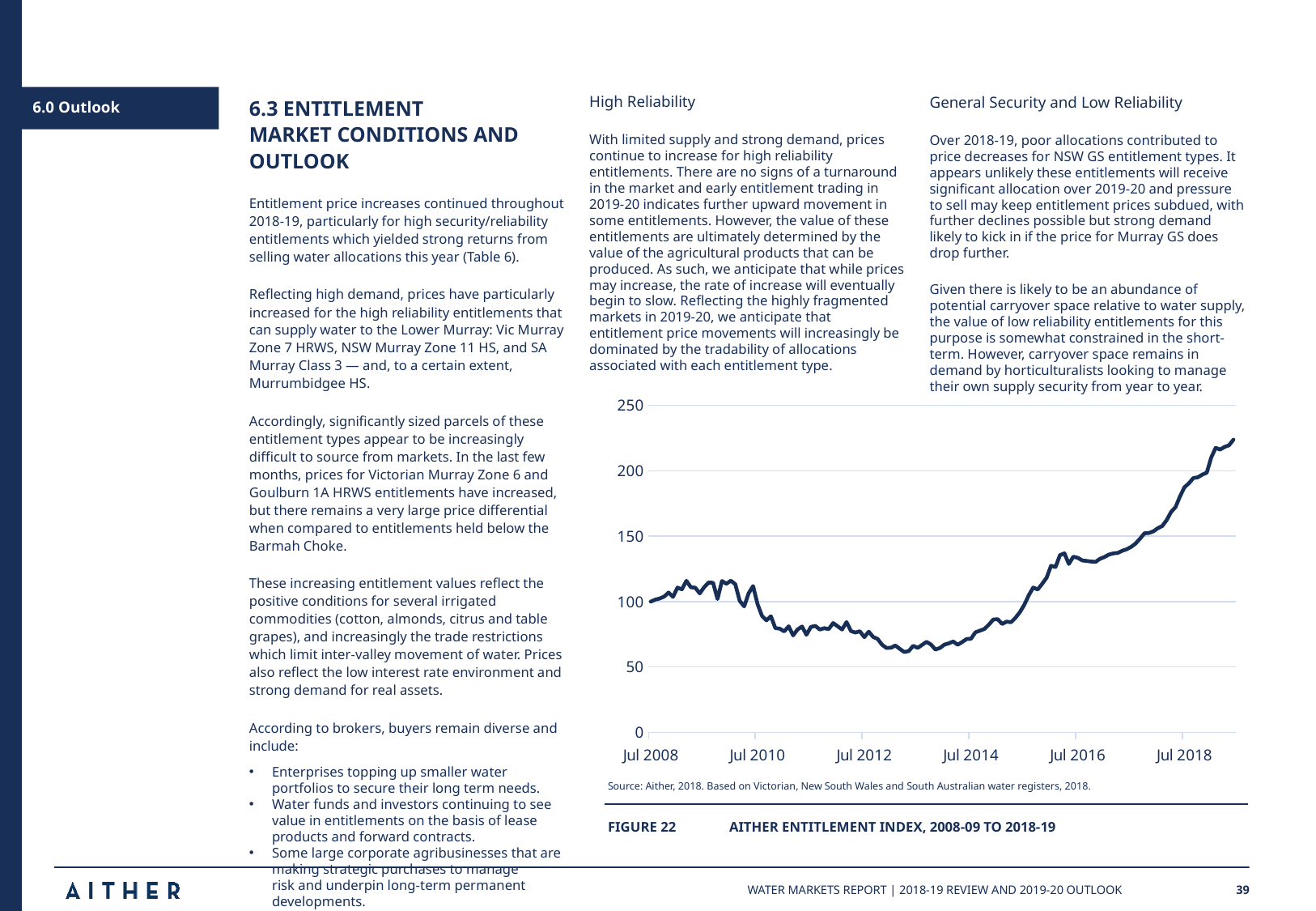
Does the Aither Entitlement Index rise or fall between Jul 2010 and Jul 2012? fall Does the Aither Entitlement Index rise or fall between Jul 2014 and Jul 2018? rise Which is larger, the Aither Entitlement Index at Jul 2012 or at Jul 2018? Jul 2018 What kind of chart is Figure 22? line chart Is the value of the Aither Entitlement Index at Jul 2016 greater or less than 100? greater Is the highest point of the Aither Entitlement Index greater or less than 200? greater Is the value of the Aither Entitlement Index at Jul 2018 greater or less than 150? greater What is the title of the chart in Figure 22? AITHER ENTITLEMENT INDEX, 2008-09 TO 2018-19 How many year labels are shown on the x axis of the chart? 6 What is the highest value shown on the y axis of the chart? 250